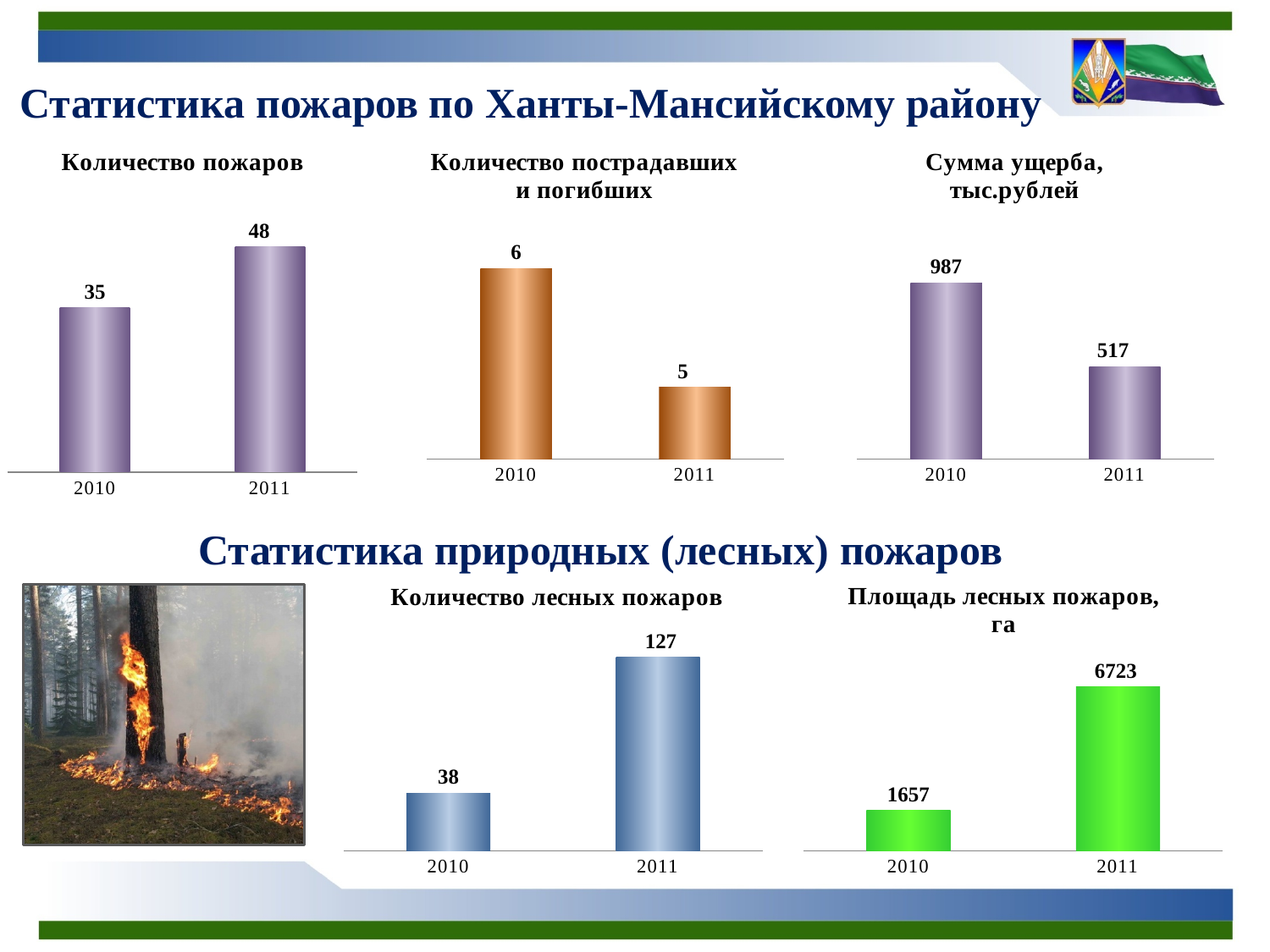
In the chart titled "Площадь лесных пожаров, га", what is the value for 2010? 1657 In the chart titled "Количество пострадавших и погибших", what is the value for 2010? 6 In the chart titled "Площадь лесных пожаров, га", what is the difference between the 2011 and 2010 values? 5066 In the chart titled "Сумма ущерба, тыс.рублей", what is the value for 2011? 517 In the chart titled "Количество пострадавших и погибших", is the value for 2010 larger or smaller than the value for 2011? larger In the chart titled "Количество лесных пожаров", which year has the higher value? 2011 In the chart titled "Количество пожаров", what is the value for 2011? 48 In the chart titled "Количество лесных пожаров", do the values rise or fall from 2010 to 2011? rise In the chart titled "Сумма ущерба, тыс.рублей", which year has the lower value? 2011 What type of chart is the chart titled "Сумма ущерба, тыс.рублей"? bar chart How many bars are in the chart titled "Количество лесных пожаров"? 2 In the chart titled "Количество пожаров", what is the difference between the 2011 and 2010 values? 13